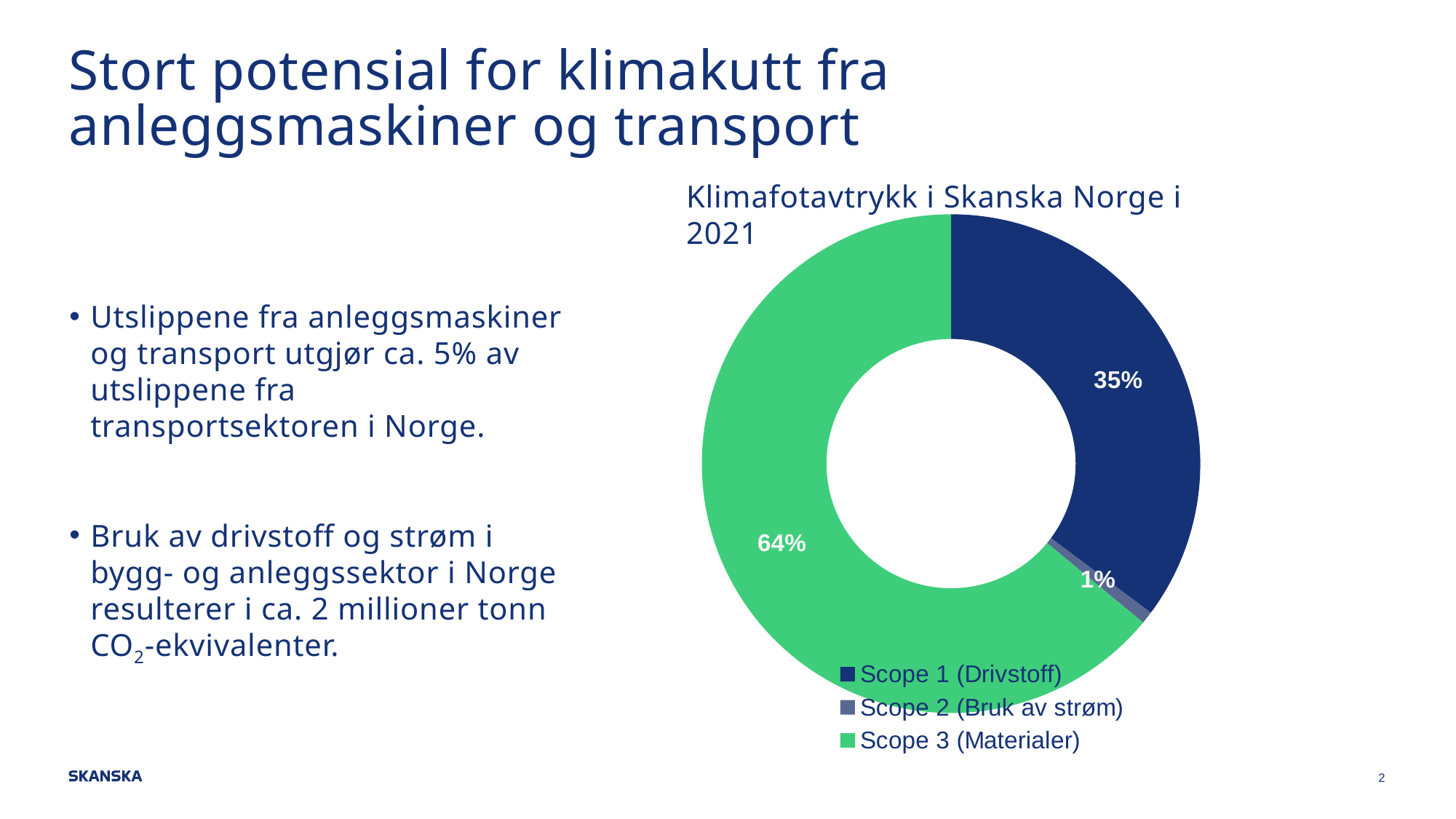
What share of the chart does Scope 1 (Drivstoff) represent? 35% What share of the chart does Scope 3 (Materialer) represent? 64% Which category has the smallest share of the chart? Scope 2 (Bruk av strøm) Which is larger, the share for Scope 1 (Drivstoff) or the share for Scope 2 (Bruk av strøm)? Scope 1 (Drivstoff) What share of the chart does Scope 2 (Bruk av strøm) represent? 1% Which colour represents Scope 3 (Materialer) in the chart? Green What is the difference in percentage points between Scope 3 (Materialer) and Scope 1 (Drivstoff)? 29 percentage points How many categories does the chart show? 3 What is the combined share of Scope 1 (Drivstoff) and Scope 2 (Bruk av strøm)? 36% Which category has the largest share of the chart? Scope 3 (Materialer) What kind of chart is shown on the slide? Doughnut (pie) chart What is the title of the chart? Klimafotavtrykk i Skanska Norge i 2021